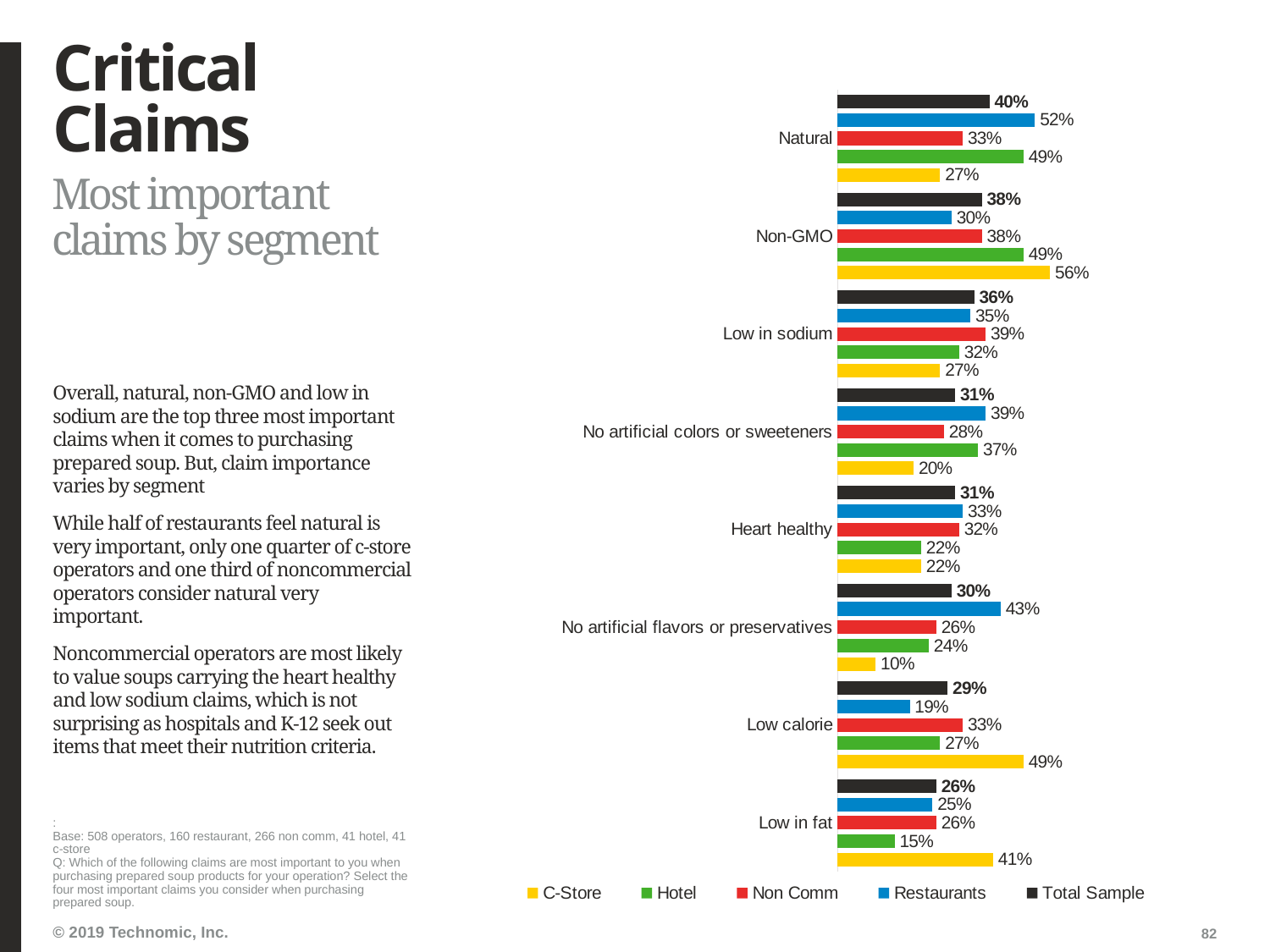
What is the difference between the Restaurants and C-Store values for Natural? 25% How many series does the legend list? 5 Which colour represents the Non Comm series in the chart? Red How many claims are listed on the chart? 8 For Low calorie, which is larger: the C-Store value or the Restaurants value? C-Store Which claim has the highest Total Sample value? Natural What is the Hotel value for Low in fat? 15% Which claim has the lowest C-Store value? No artificial flavors or preservatives What type of chart is shown on the slide? Bar chart What percentage of Restaurants rated Natural as important? 52% What is the Total Sample value for Natural? 40% What is the C-Store value for Non-GMO? 56%